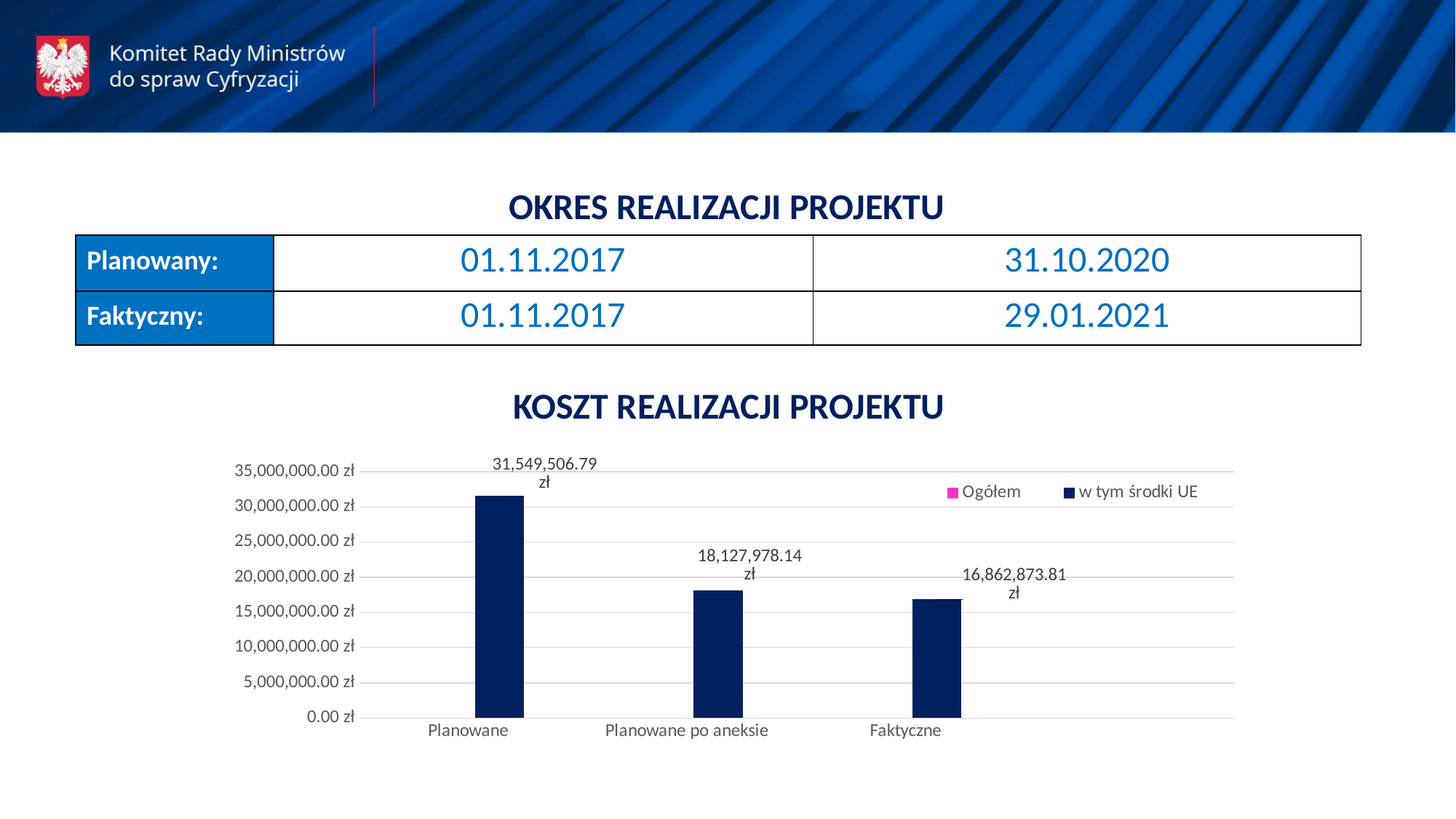
What is the value shown for Faktyczne in the KOSZT REALIZACJI PROJEKTU chart? 16,862,873.81 zł Which category has the lowest value in the KOSZT REALIZACJI PROJEKTU chart? Faktyczne In the KOSZT REALIZACJI PROJEKTU chart, what is the difference between the Planowane po aneksie and Faktyczne values? 1,265,104.33 zł What is the value shown for Planowane po aneksie in the KOSZT REALIZACJI PROJEKTU chart? 18,127,978.14 zł How many categories are shown on the x axis of the KOSZT REALIZACJI PROJEKTU chart? 3 What is the value shown for Planowane in the KOSZT REALIZACJI PROJEKTU chart? 31,549,506.79 zł In the KOSZT REALIZACJI PROJEKTU chart, which is larger: the value for Planowane or the value for Faktyczne? Planowane Which category has the highest value in the KOSZT REALIZACJI PROJEKTU chart? Planowane In the KOSZT REALIZACJI PROJEKTU chart, is the value for Faktyczne greater or less than 20,000,000.00 zł? less What kind of chart is the KOSZT REALIZACJI PROJEKTU chart? Bar chart In the KOSZT REALIZACJI PROJEKTU chart, what is the difference between the Planowane and Planowane po aneksie values? 13,421,528.65 zł How many series does the legend of the KOSZT REALIZACJI PROJEKTU chart list? 2